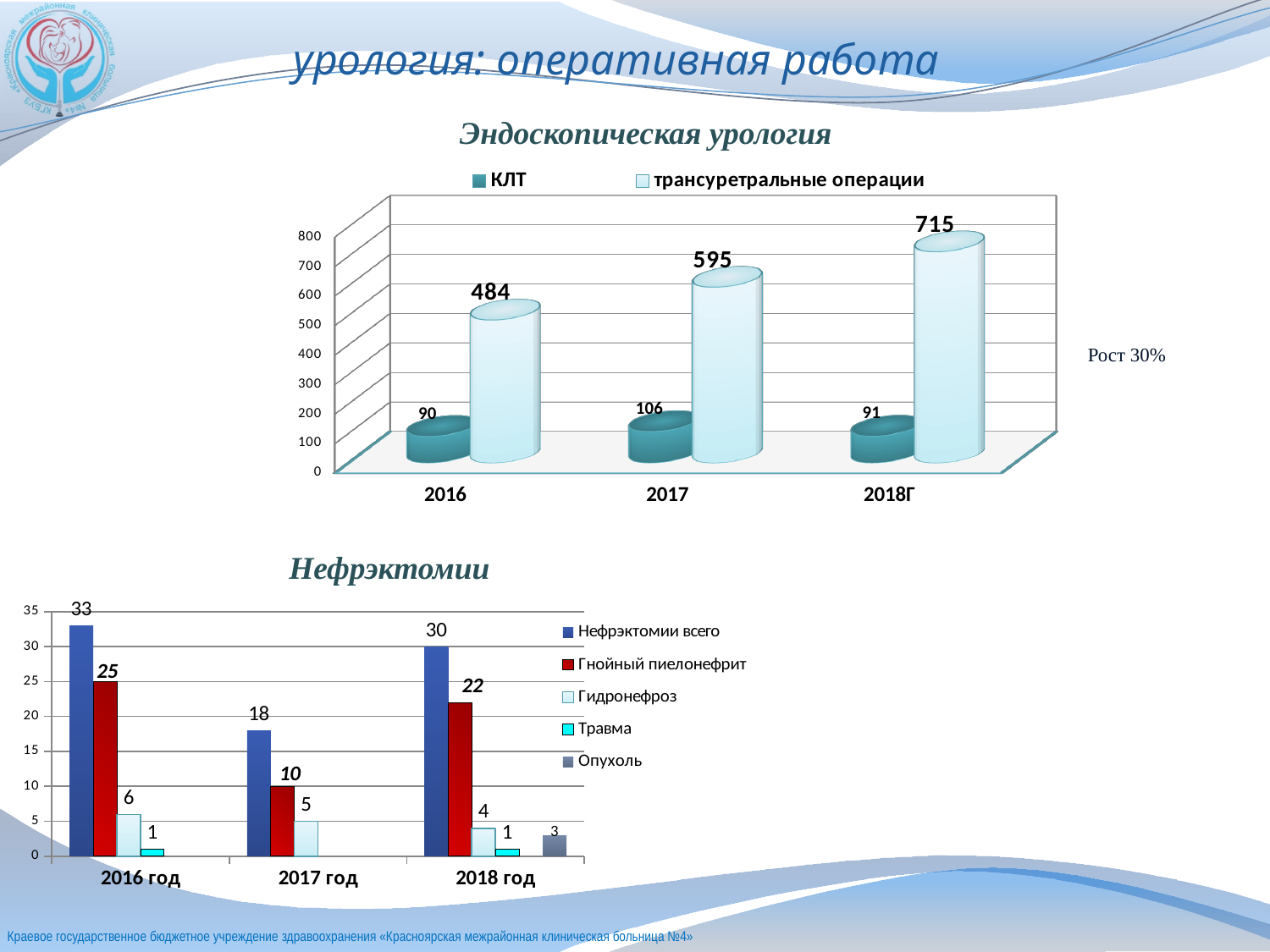
What kind of chart is the 'Нефрэктомии' chart? bar chart In the 'Нефрэктомии' chart, which is larger: Гидронефроз in 2016 год or Гидронефроз in 2018 год? 2016 год In the 'Нефрэктомии' chart, which year has the lowest value for Нефрэктомии всего? 2017 год In the 'Эндоскопическая урология' chart, what is the value of КЛТ in 2017? 106 In the 'Эндоскопическая урология' chart, which year has the highest value for трансуретральные операции? 2018Г How many series does the legend of the 'Нефрэктомии' chart list? 5 In the 'Нефрэктомии' chart, what is the value of Нефрэктомии всего for 2017 год? 18 How many series does the legend of the 'Эндоскопическая урология' chart list? 2 In the 'Нефрэктомии' chart, what is the value of Гнойный пиелонефрит for 2018 год? 22 In the 'Эндоскопическая урология' chart, what is the value of трансуретральные операции in 2018Г? 715 In the 'Эндоскопическая урология' chart, do the values for трансуретральные операции rise or fall from 2016 to 2018Г? rise In the 'Эндоскопическая урология' chart, what is the difference between трансуретральные операции in 2018Г and 2016? 231